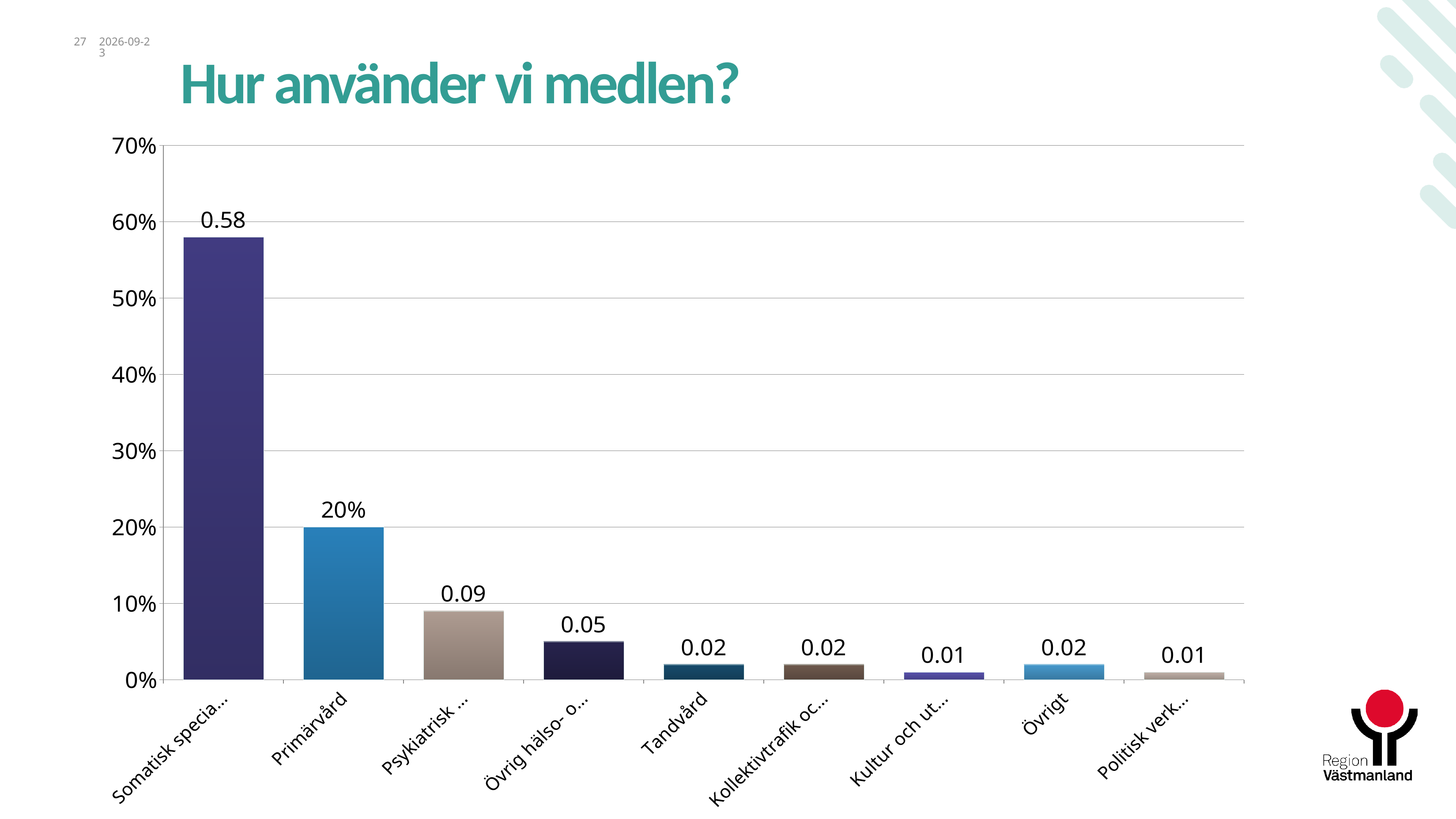
Is the value of the leftmost bar greater or less than 50%? greater What is the title of the slide? Hur använder vi medlen? What is the data label shown above the Övrigt bar? 0.02 What is the data label shown above the first (leftmost) bar? 0.58 What kind of chart is shown on the slide? bar chart What is the data label shown above the Tandvård bar? 0.02 Which is larger, the value for Primärvård or the value for Tandvård? Primärvård What is the value shown for Primärvård? 20% How many bars are plotted in the chart? 9 What is the highest tick value shown on the vertical axis? 70% Do the bar values generally rise or fall from left to right across the chart? fall Is the value for Primärvård greater or less than 10%? greater